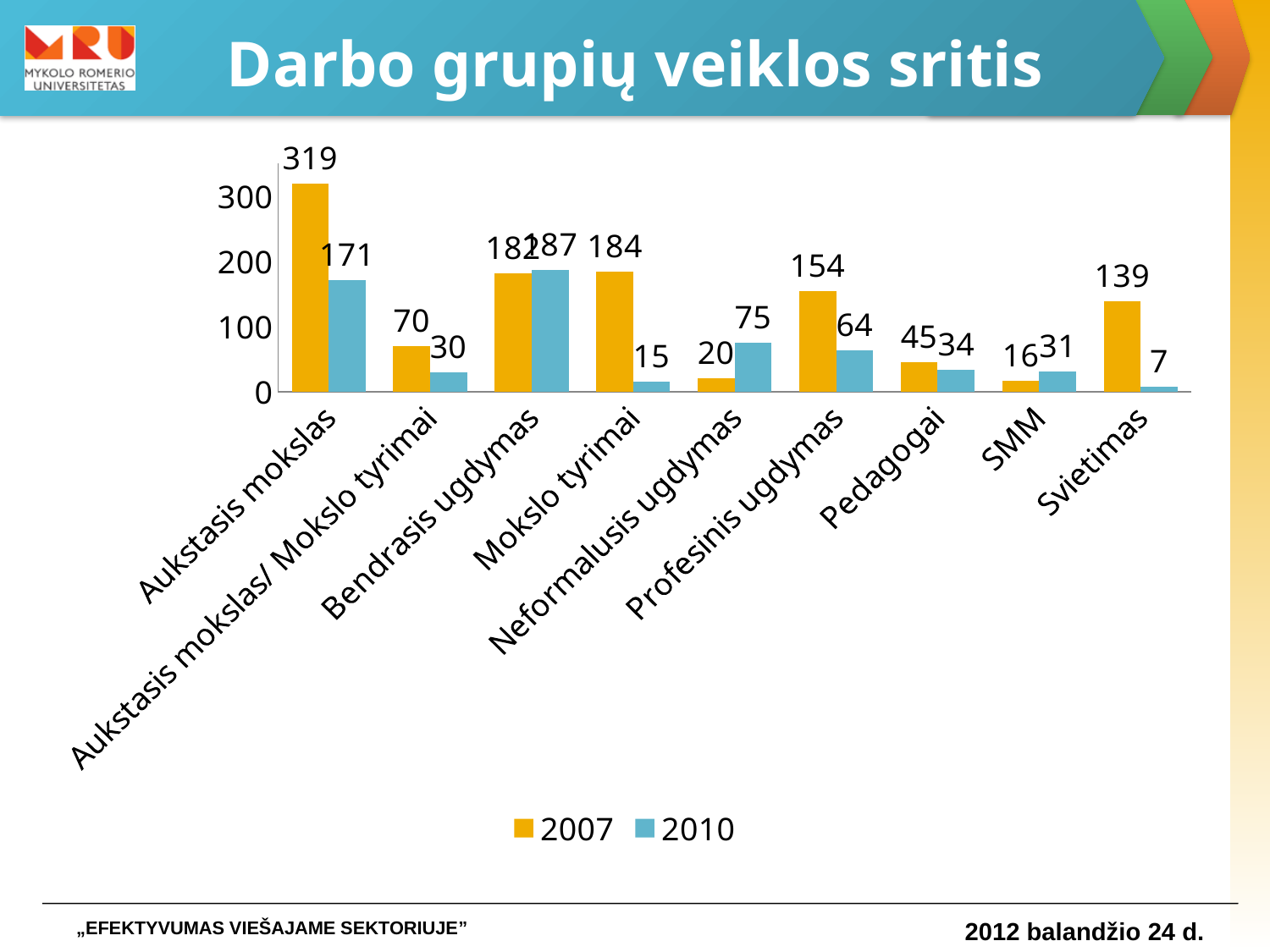
What kind of chart is shown on the slide? Bar chart What is the 2007 value for Profesinis ugdymas? 154 What is the 2010 value for Neformalusis ugdymas? 75 How many categories are shown on the x axis? 9 Which category has the highest 2007 value? Aukstasis mokslas What is the difference between the 2007 and 2010 values for Mokslo tyrimai? 169 What is the 2010 value for Svietimas? 7 How many series does the legend list? 2 Which is larger for SMM, the 2007 value or the 2010 value? 2010 Which category has the lowest 2010 value? Svietimas What is the 2007 value for Aukstasis mokslas? 319 What is the title of the slide? Darbo grupių veiklos sritis